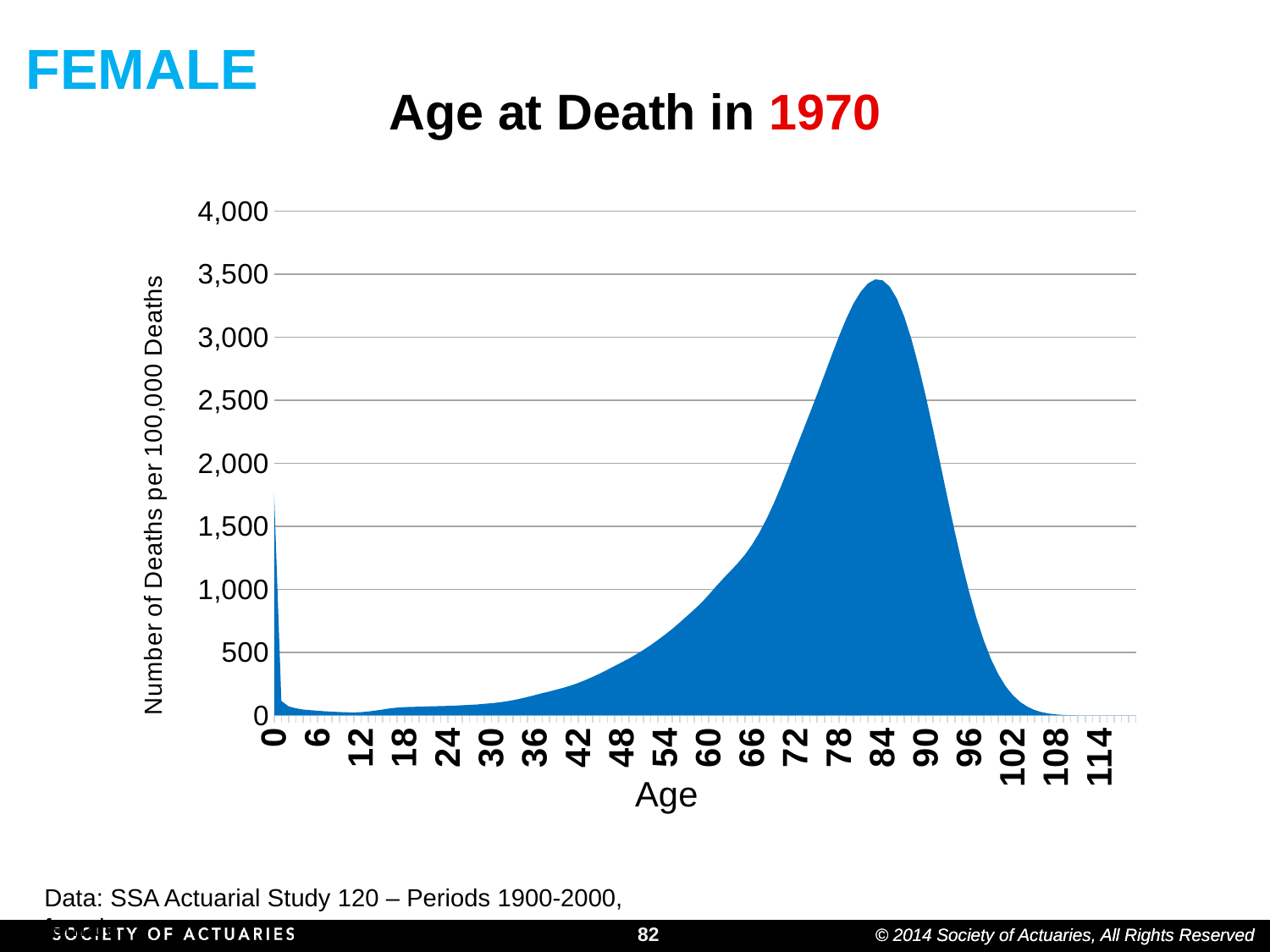
What kind of chart is shown on the slide? area chart What is the highest value shown on the vertical axis? 4,000 Is the value at age 0 greater or less than 1,000? greater Is the peak value of the curve greater or less than 3,000? greater Is the value at age 102 greater or less than 500? less What is the label of the vertical axis? Number of Deaths per 100,000 Deaths Between age 36 and age 78, do the values rise or fall as age increases? rise What is the title of the chart? Age at Death in 1970 Between age 90 and age 108, do the values rise or fall as age increases? fall Is the value at age 84 larger or smaller than the value at age 60? larger